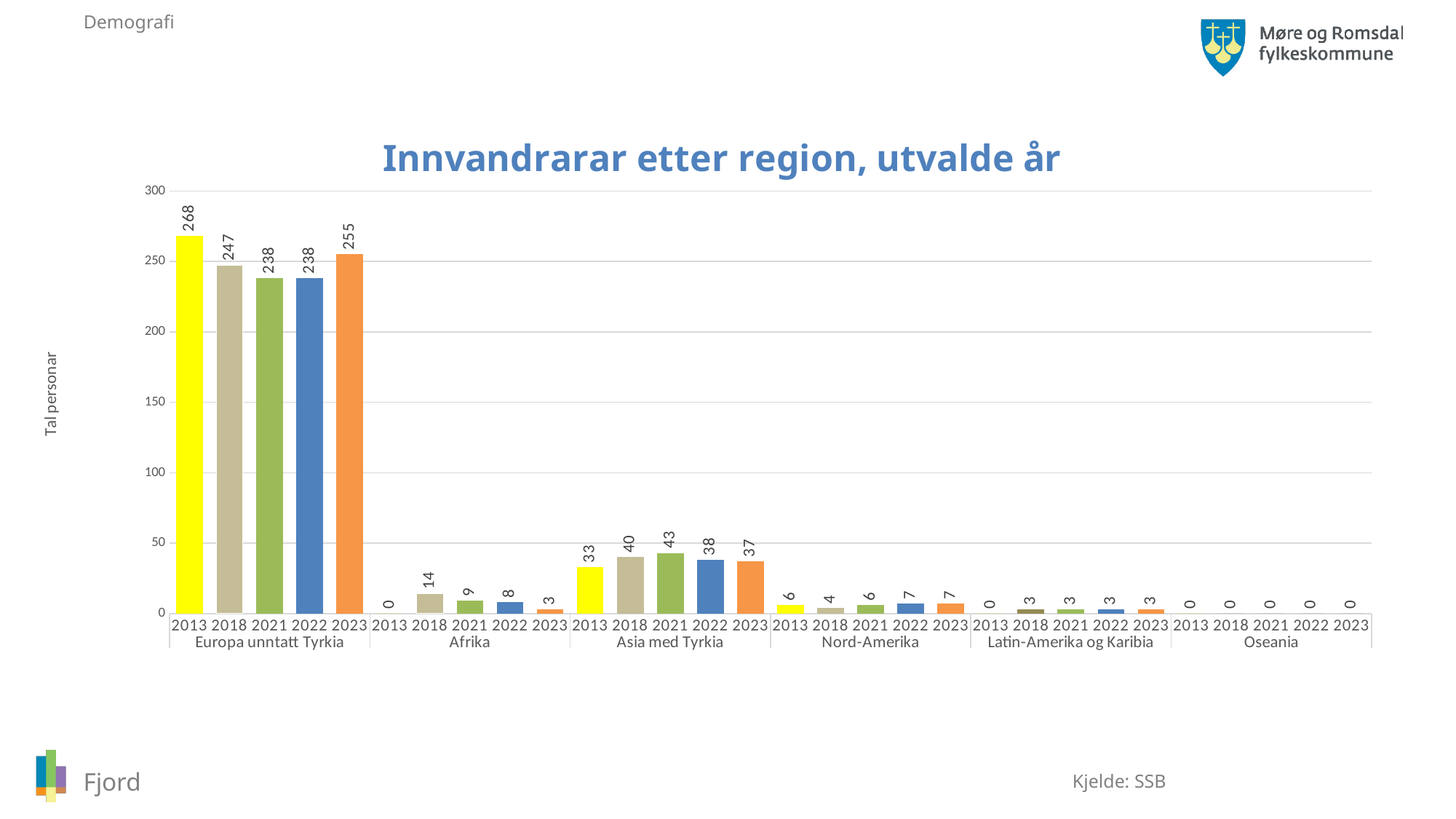
Which is larger, the 2018 value for Afrika or the 2018 value for Nord-Amerika? Afrika What is the difference between the 2013 and 2023 values for Europa unntatt Tyrkia? 13 What is the value for Europa unntatt Tyrkia in 2013? 268 Which region has the highest value in 2023? Europa unntatt Tyrkia What kind of chart is shown on the slide? bar chart What is the value for Asia med Tyrkia in 2021? 43 Is the value for Europa unntatt Tyrkia in 2022 greater or less than 200? greater What is the value for Afrika in 2018? 14 What is the value for Nord-Amerika in 2022? 7 How many regions are shown on the x axis? 6 What is the title of the chart? Innvandrarar etter region, utvalde år Which region has the lowest value in 2023? Oseania